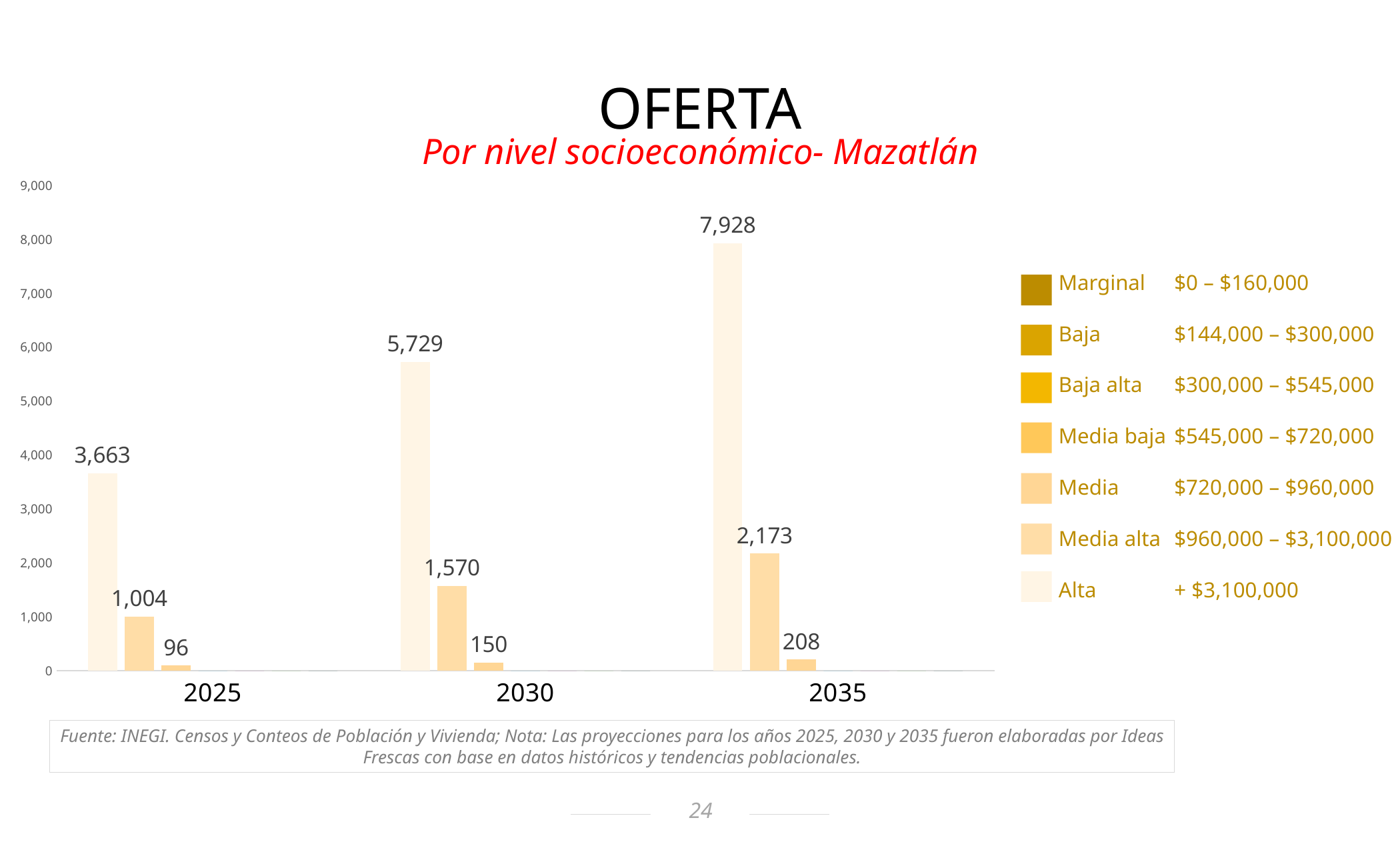
How many years are shown on the x axis? 3 What is the difference between the two labeled values 1,004 and 96 for 2025? 908 How many socioeconomic levels does the legend list? 7 What is the value of the tallest bar for 2035? 7,928 What price range does the legend give for the 'Alta' level? + $3,100,000 What is the difference between the tallest bar for 2035 (7,928) and the tallest bar for 2030 (5,729)? 2,199 What is the value of the tallest bar for 2030? 5,729 What is the value of the tallest bar for 2025? 3,663 What kind of chart is shown on the slide? bar chart What is the smallest labeled value for 2030? 150 Which is larger: the second-tallest bar for 2035 (2,173) or the second-tallest bar for 2030 (1,570)? 2035 (2,173) Does the tallest bar in each year rise or fall from 2025 to 2035? rise